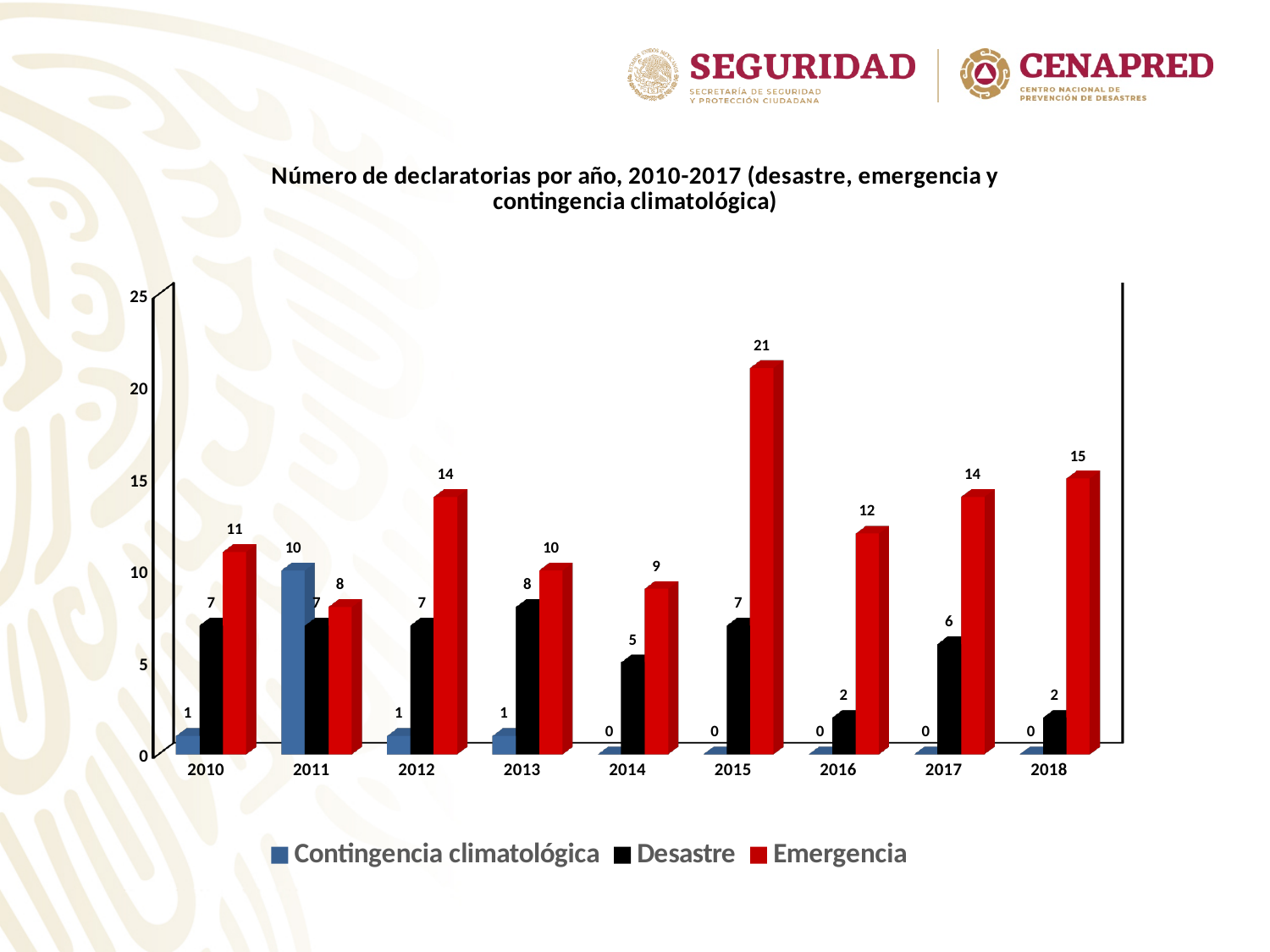
What is the Desastre value for 2013? 8 What is the Emergencia value for 2015? 21 Which year has the lowest Emergencia value? 2011 How many series does the legend list? 3 What is the difference between the Emergencia values for 2015 and 2016? 9 Which year has the highest Emergencia value? 2015 Is the Emergencia value for 2012 greater or less than 10? greater What is the Contingencia climatológica value for 2011? 10 Which is larger, the Desastre value for 2017 or the Desastre value for 2018? 2017 Which colour represents the Emergencia series? red What kind of chart is shown on the slide? bar chart How many years are shown on the x axis? 9